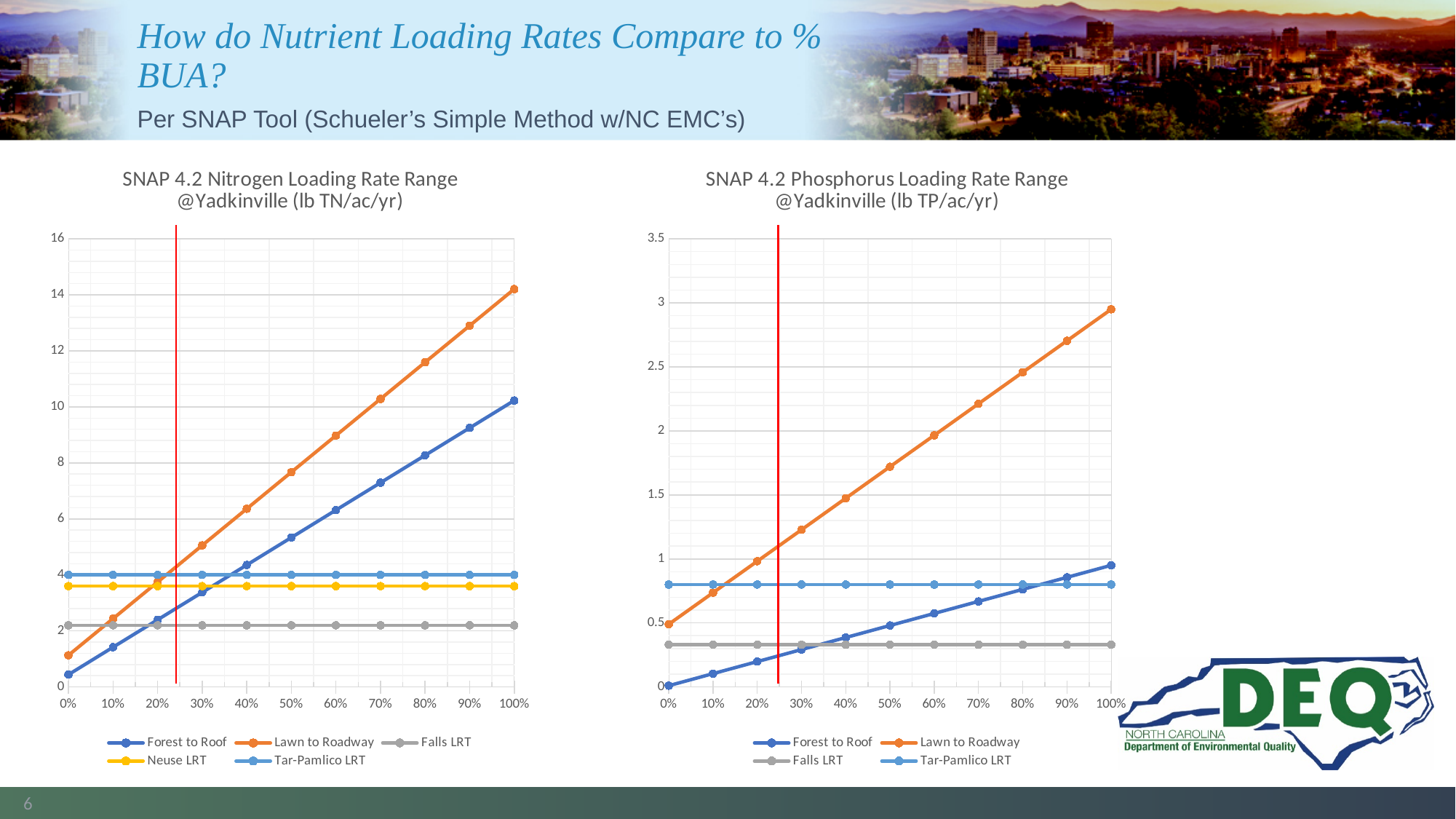
How many x-axis categories (percentage points) are shown on the SNAP 4.2 Phosphorus Loading Rate Range chart? 11 In the SNAP 4.2 Phosphorus Loading Rate Range chart, is the Falls LRT value greater or less than 0.5? less In the SNAP 4.2 Nitrogen Loading Rate Range chart, which series has the highest value at 100%? Lawn to Roadway In the SNAP 4.2 Nitrogen Loading Rate Range chart, is the Lawn to Roadway value at 100% greater or less than 12? greater In the SNAP 4.2 Phosphorus Loading Rate Range chart, does the Falls LRT series rise, fall, or stay flat across the x axis? stay flat Which series appears in the legend of the Nitrogen chart but not in the legend of the Phosphorus chart? Neuse LRT In the SNAP 4.2 Phosphorus Loading Rate Range chart, at 100%, which is larger: Forest to Roof or Lawn to Roadway? Lawn to Roadway In the SNAP 4.2 Nitrogen Loading Rate Range chart, is the Forest to Roof value at 100% greater or less than 8? greater What kind of chart is the SNAP 4.2 Nitrogen Loading Rate Range chart? line chart How many series does the legend of the SNAP 4.2 Phosphorus Loading Rate Range chart list? 4 In the SNAP 4.2 Nitrogen Loading Rate Range chart, does the Lawn to Roadway series rise or fall as the x axis goes from 0% to 100%? rise How many series does the legend of the SNAP 4.2 Nitrogen Loading Rate Range chart list? 5